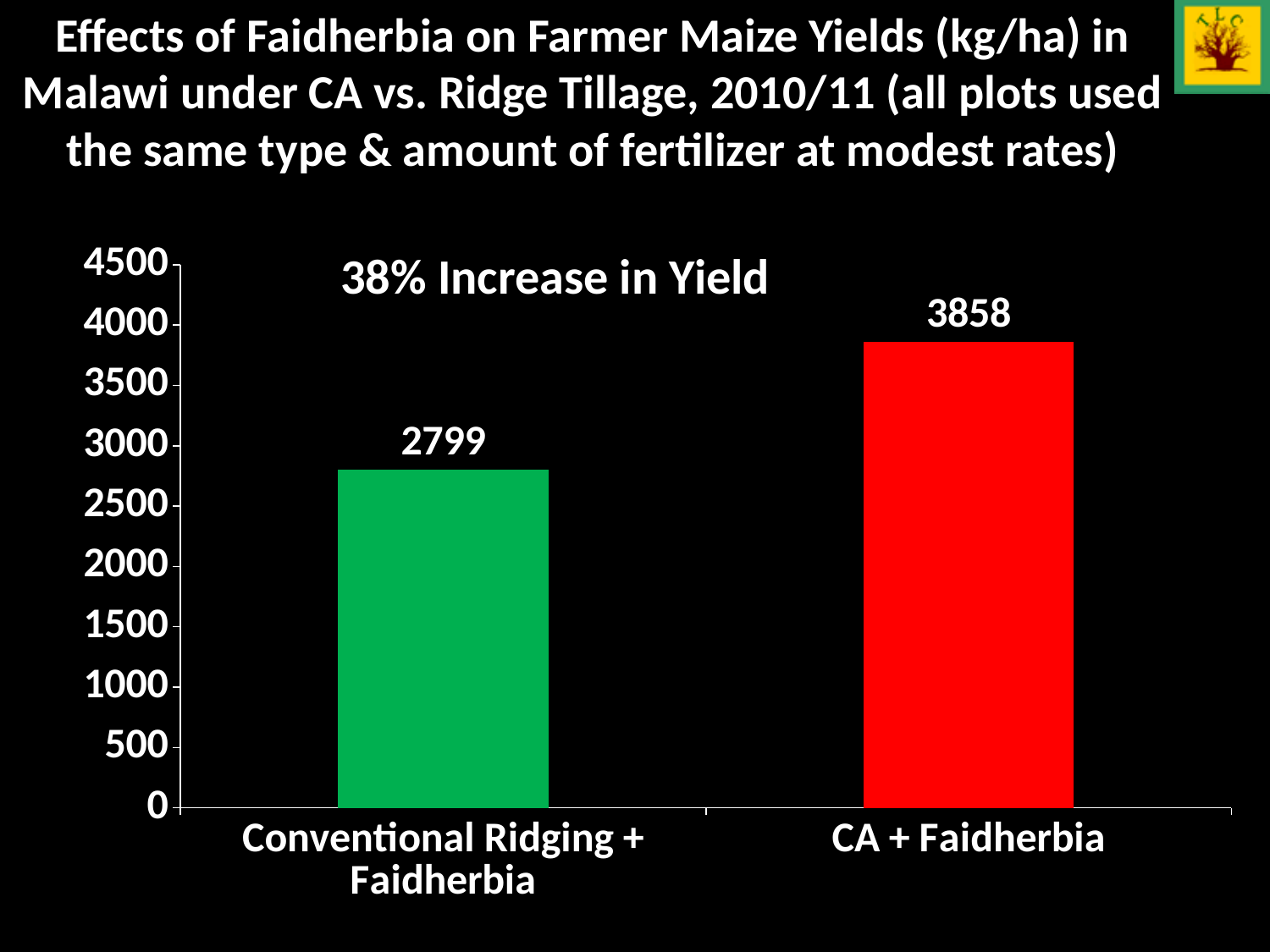
Is the value for Conventional Ridging + Faidherbia greater or less than 3000? less What percentage increase in yield is stated on the chart? 38% What kind of chart is shown on the slide? bar chart What is the maize yield for Conventional Ridging + Faidherbia? 2799 How many categories are shown in the chart? 2 Is the value for CA + Faidherbia greater or less than 3500? greater What is the difference in yield between CA + Faidherbia and Conventional Ridging + Faidherbia? 1059 What is the maize yield for CA + Faidherbia? 3858 What colour is the bar for CA + Faidherbia? red Which category has the lowest maize yield? Conventional Ridging + Faidherbia Which is larger, the yield for CA + Faidherbia or for Conventional Ridging + Faidherbia? CA + Faidherbia Which category has the highest maize yield? CA + Faidherbia